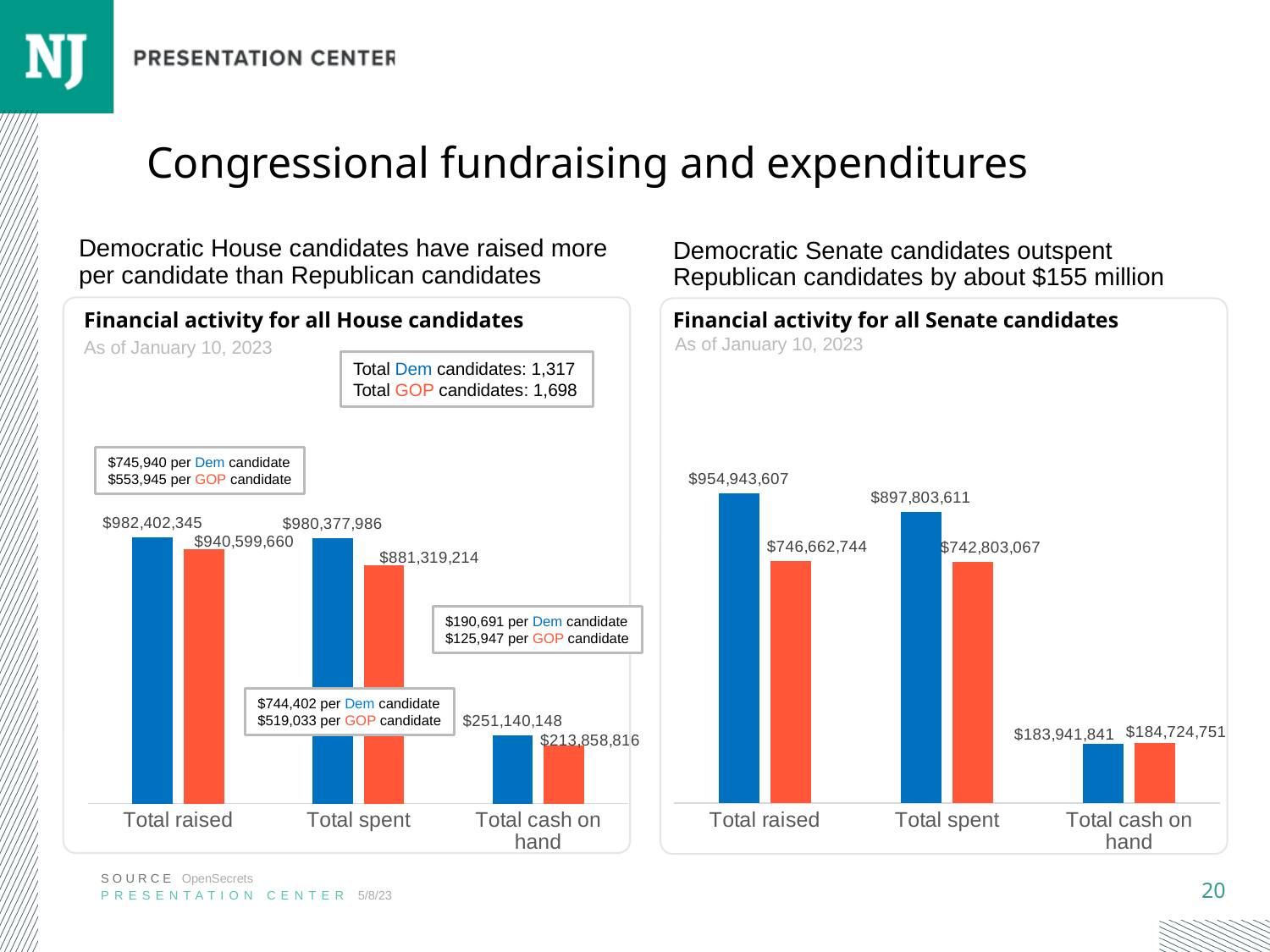
In the 'Financial activity for all Senate candidates' chart, what is the value of the blue (Democratic) bar for Total raised? $954,943,607 How many categories are shown on the x axis of the 'Financial activity for all House candidates' chart? 3 In the 'Financial activity for all House candidates' chart, which category has the lowest values? Total cash on hand In the 'Financial activity for all House candidates' chart, what is the difference between the blue and orange bars for Total raised? $41,802,685 In the 'Financial activity for all Senate candidates' chart, what is the difference between the blue and orange bars for Total spent? $155,000,544 In the 'Financial activity for all House candidates' chart, what is the per-candidate amount for Dem candidates for Total raised? $745,940 In the 'Financial activity for all Senate candidates' chart, which is larger for Total raised: the blue bar or the orange bar? The blue bar What date are both charts reported as of? January 10, 2023 In the 'Financial activity for all House candidates' chart, what is the value of the orange (GOP) bar for Total spent? $881,319,214 In the 'Financial activity for all Senate candidates' chart, what is the value of the orange (GOP) bar for Total cash on hand? $184,724,751 What type of chart is 'Financial activity for all Senate candidates'? Bar chart In the 'Financial activity for all House candidates' chart, what is the value of the blue (Democratic) bar for Total raised? $982,402,345